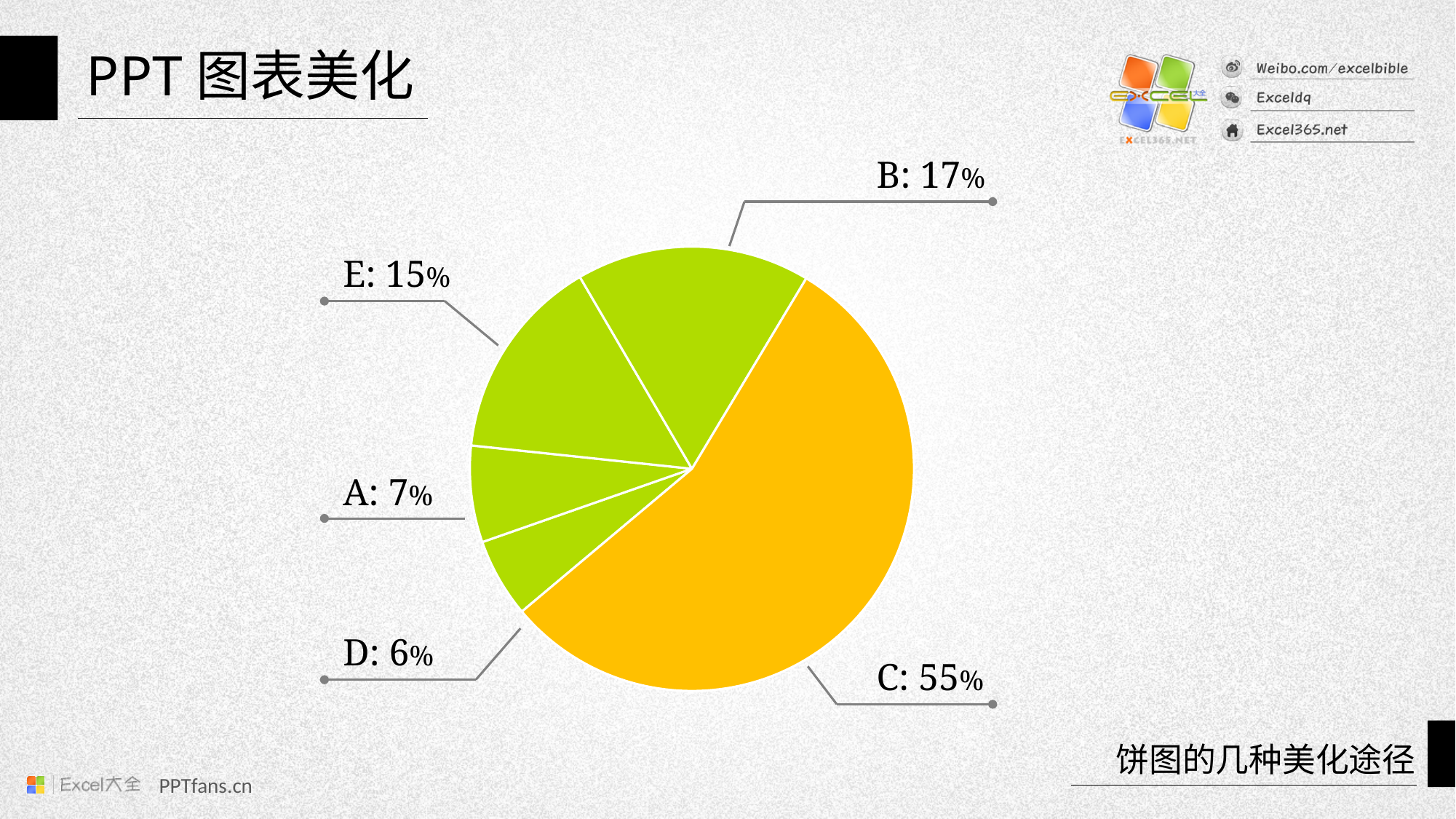
How many slices does the pie chart have? 5 Which is larger, slice B or slice E? B What is the difference between the values for C and B? 38% What is the value for slice E? 15% What is the value for slice D? 6% What kind of chart is shown on the slide? pie chart What colour is slice C? orange What is the value for slice C? 55% What is the value for slice A? 7% What is the value for slice B? 17% Which slice is the smallest? D Which slice is the largest? C